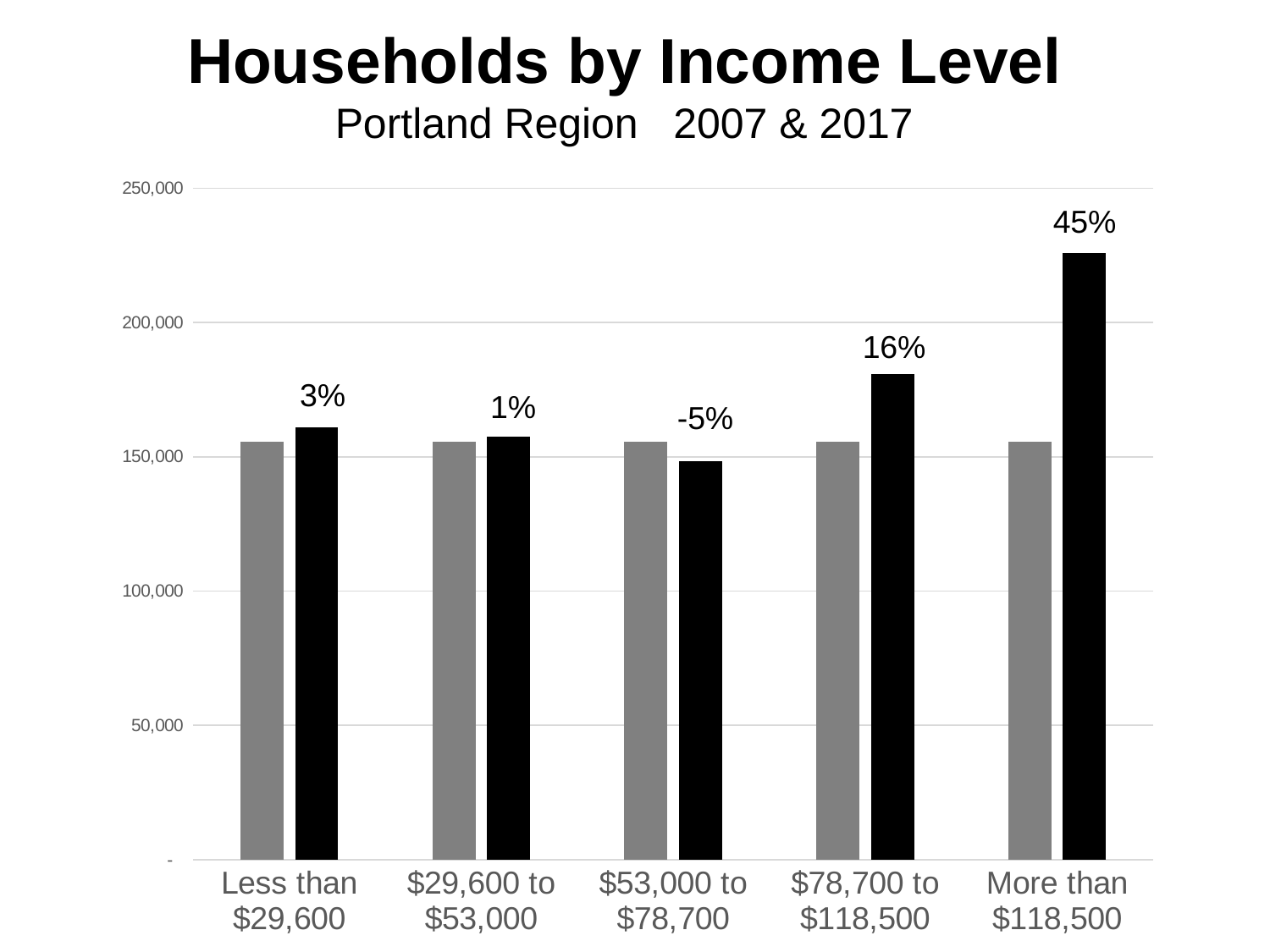
What kind of chart is shown on the slide? bar chart Is the value of the black bar for '$53,000 to $78,700' greater or less than 150,000? less What percentage label is shown above the bar for the 'More than $118,500' category? 45% Which income level category has the lowest percentage label? $53,000 to $78,700 What percentage label is shown above the bar for the 'Less than $29,600' category? 3% Is the value of the black bar for 'More than $118,500' greater or less than 200,000? greater What percentage label is shown above the bar for the '$78,700 to $118,500' category? 16% Which is larger: the black bar for 'More than $118,500' or the black bar for '$78,700 to $118,500'? More than $118,500 What is the title of the chart? Households by Income Level Which income level category has the highest percentage label? More than $118,500 How many income level categories are shown on the x axis? 5 What percentage label is shown above the bar for the '$53,000 to $78,700' category? -5%